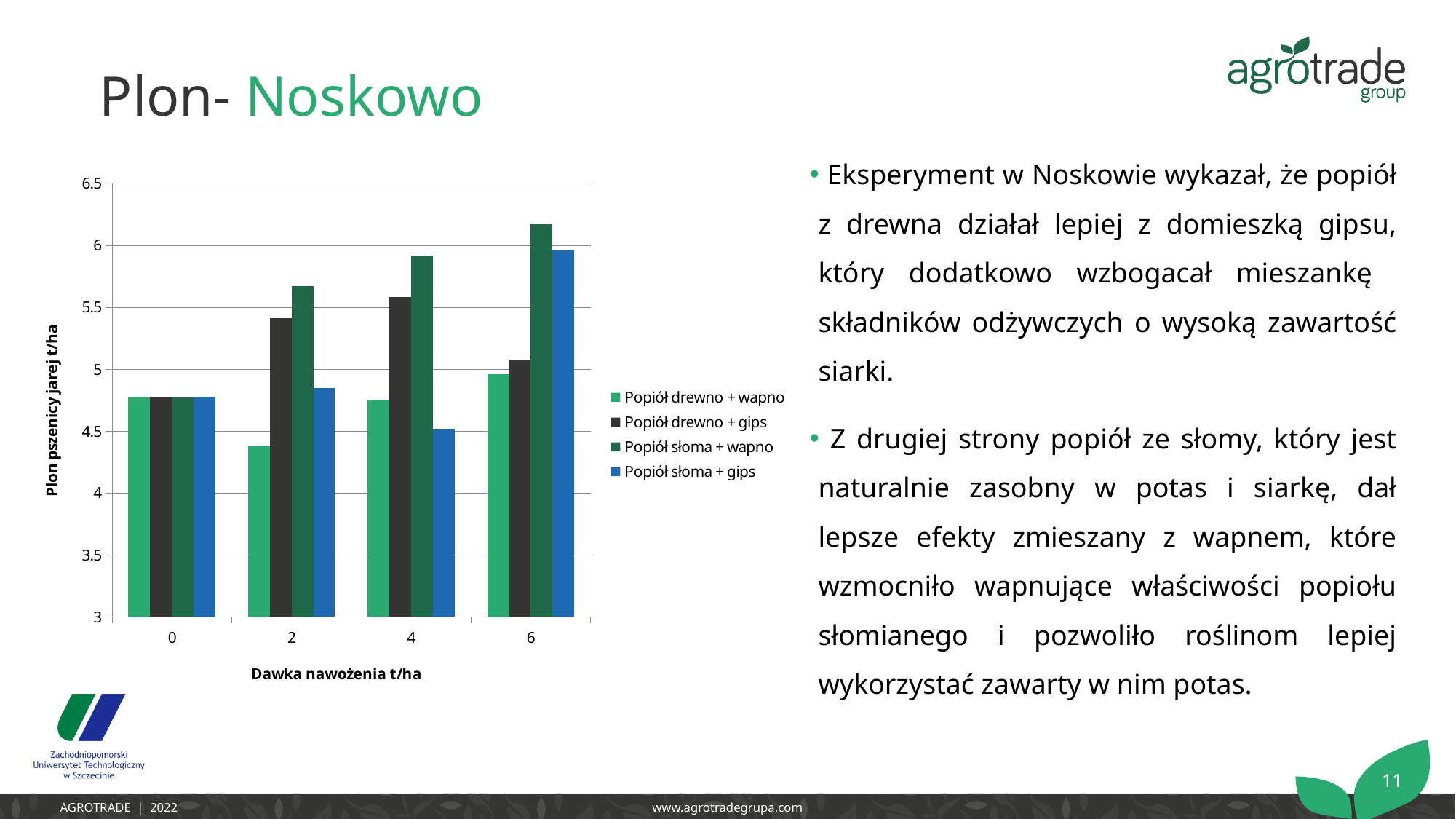
Is the value for Popiół słoma + wapno at dose 6 greater or less than 6? greater Is the value for Popiół słoma + gips at dose 6 greater or less than 5.5? greater Is the value for Popiół drewno + wapno at dose 2 greater or less than 4.5? less Which series has the highest value at dose 4? Popiół słoma + wapno How many fertilization doses (x-axis categories) are shown in the chart? 4 What is the title of the vertical axis? Plon pszenicy jarej t/ha How many series does the legend list? 4 Which series has the lowest value at dose 4? Popiół słoma + gips At dose 2, which is larger: Popiół drewno + gips or Popiół słoma + gips? Popiół drewno + gips Does the value for Popiół słoma + wapno rise or fall as the dose increases from 0 to 6? rises What kind of chart is shown on the slide? bar chart What is the title of the horizontal axis? Dawka nawożenia t/ha